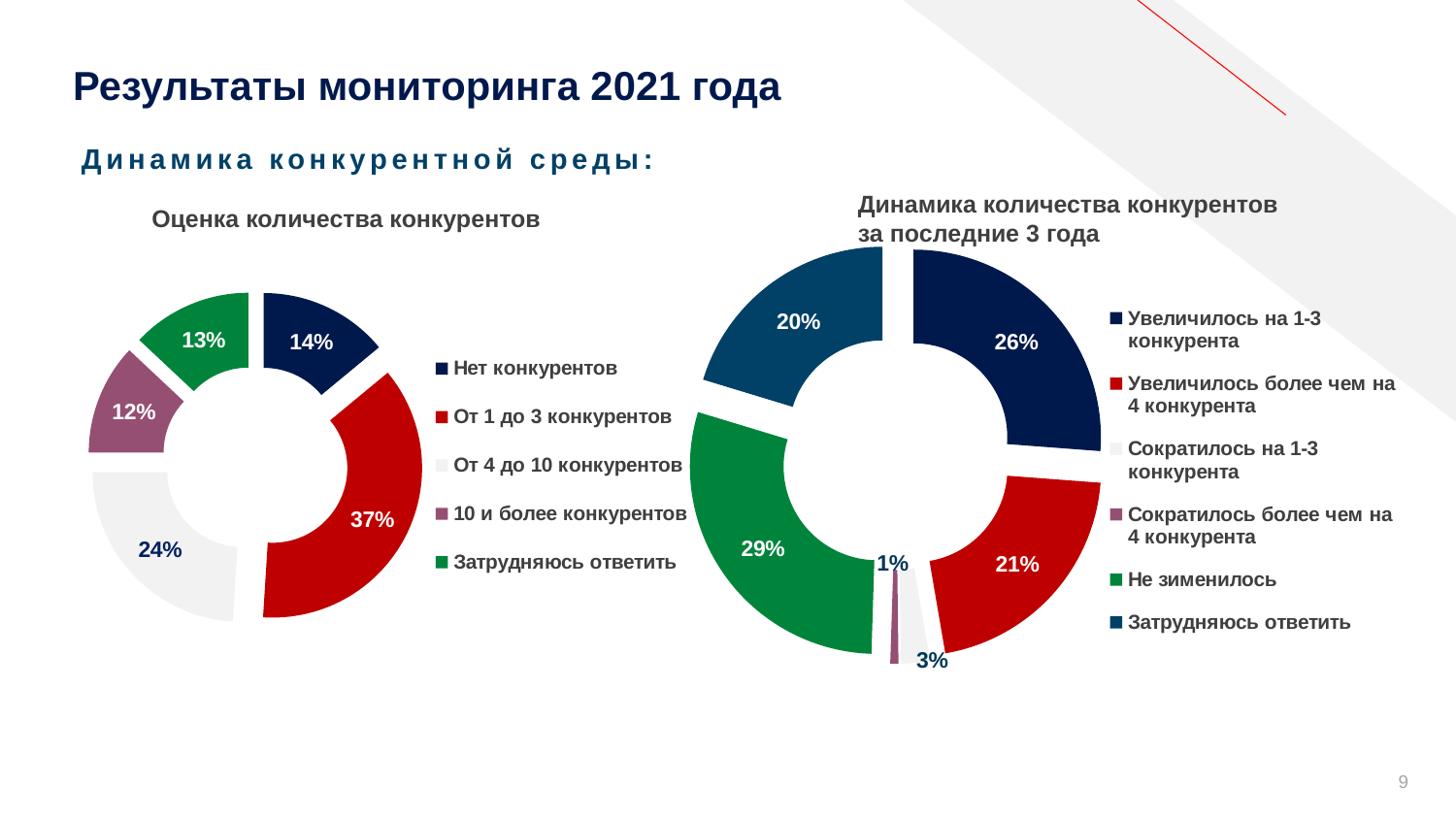
In the chart 'Динамика количества конкурентов за последние 3 года', what percentage is shown for 'Сократилось более чем на 4 конкурента'? 1% In the chart 'Оценка количества конкурентов', which category has the largest share? От 1 до 3 конкурентов How many categories does the legend of the chart 'Динамика количества конкурентов за последние 3 года' list? 6 In the chart 'Оценка количества конкурентов', which category has the smallest share? 10 и более конкурентов In the chart 'Динамика количества конкурентов за последние 3 года', which category has the smallest share? Сократилось более чем на 4 конкурента In the chart 'Оценка количества конкурентов', what percentage corresponds to 'Нет конкурентов'? 14% In the chart 'Динамика количества конкурентов за последние 3 года', which is larger: 'Увеличилось на 1-3 конкурента' or 'Увеличилось более чем на 4 конкурента'? Увеличилось на 1-3 конкурента In the chart 'Оценка количества конкурентов', what share of respondents answered 'От 1 до 3 конкурентов'? 37% What type of chart is used for 'Динамика количества конкурентов за последние 3 года'? Doughnut (pie) chart In the chart 'Динамика количества конкурентов за последние 3 года', what share corresponds to 'Не зименилось'? 29% In the chart 'Оценка количества конкурентов', what is the difference in percentage points between 'От 1 до 3 конкурентов' and 'От 4 до 10 конкурентов'? 13 How many categories does the legend of the chart 'Оценка количества конкурентов' list? 5